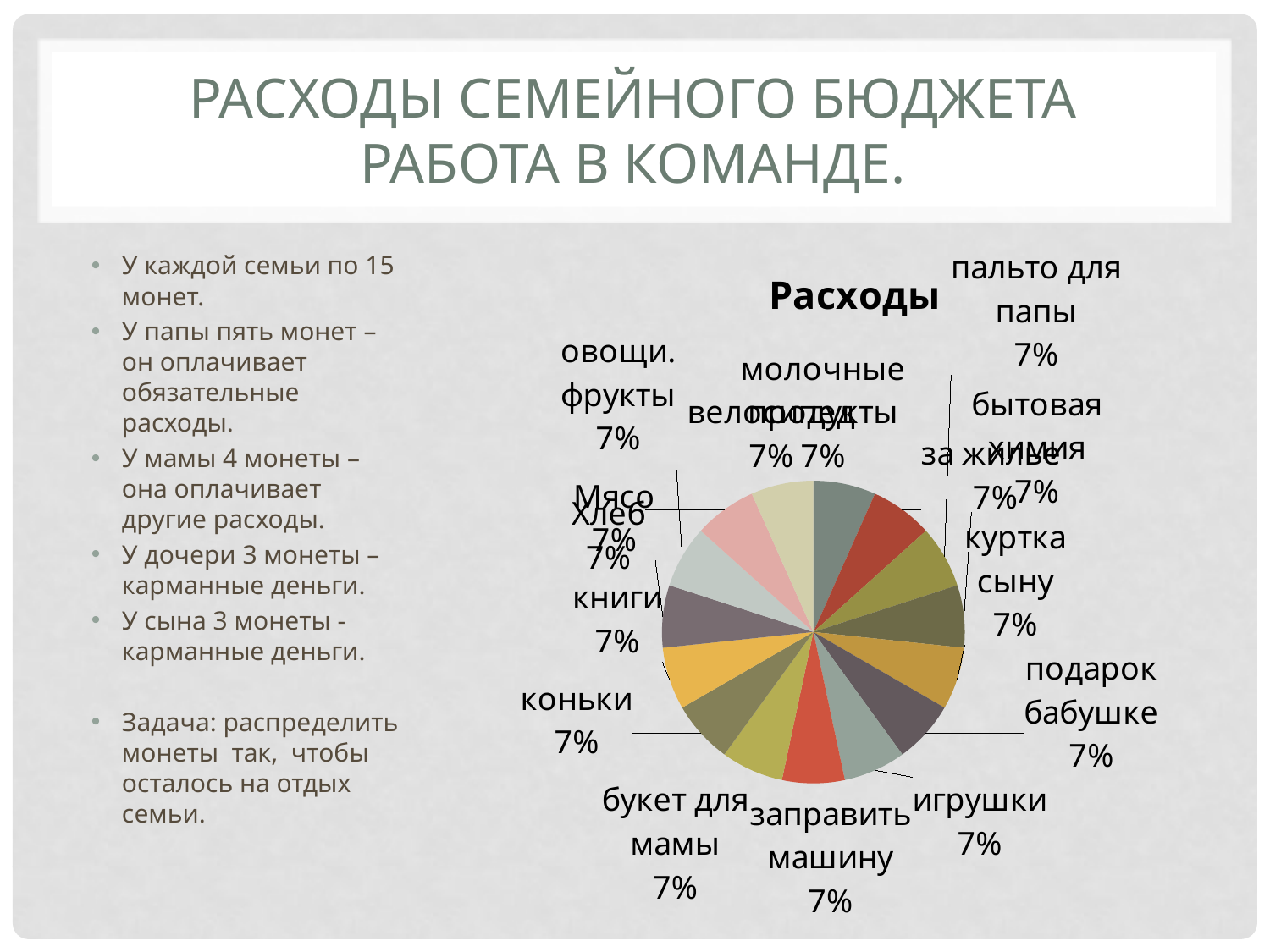
What share of the pie does the slice "пальто для папы" take? 7% What value is shown for "за жилье"? 7% What is the title of the chart? Расходы What share of the pie does "букет для мамы" take? 7% What value is shown for "овощи. фрукты"? 7% What value is shown for "заправить машину"? 7% What share of the pie does "куртка сыну" take? 7% What value is shown for "книги"? 7% What value is shown for "коньки"? 7% What value is shown for "игрушки"? 7% What kind of chart is shown on the slide? pie chart What value is shown for "подарок бабушке"? 7%